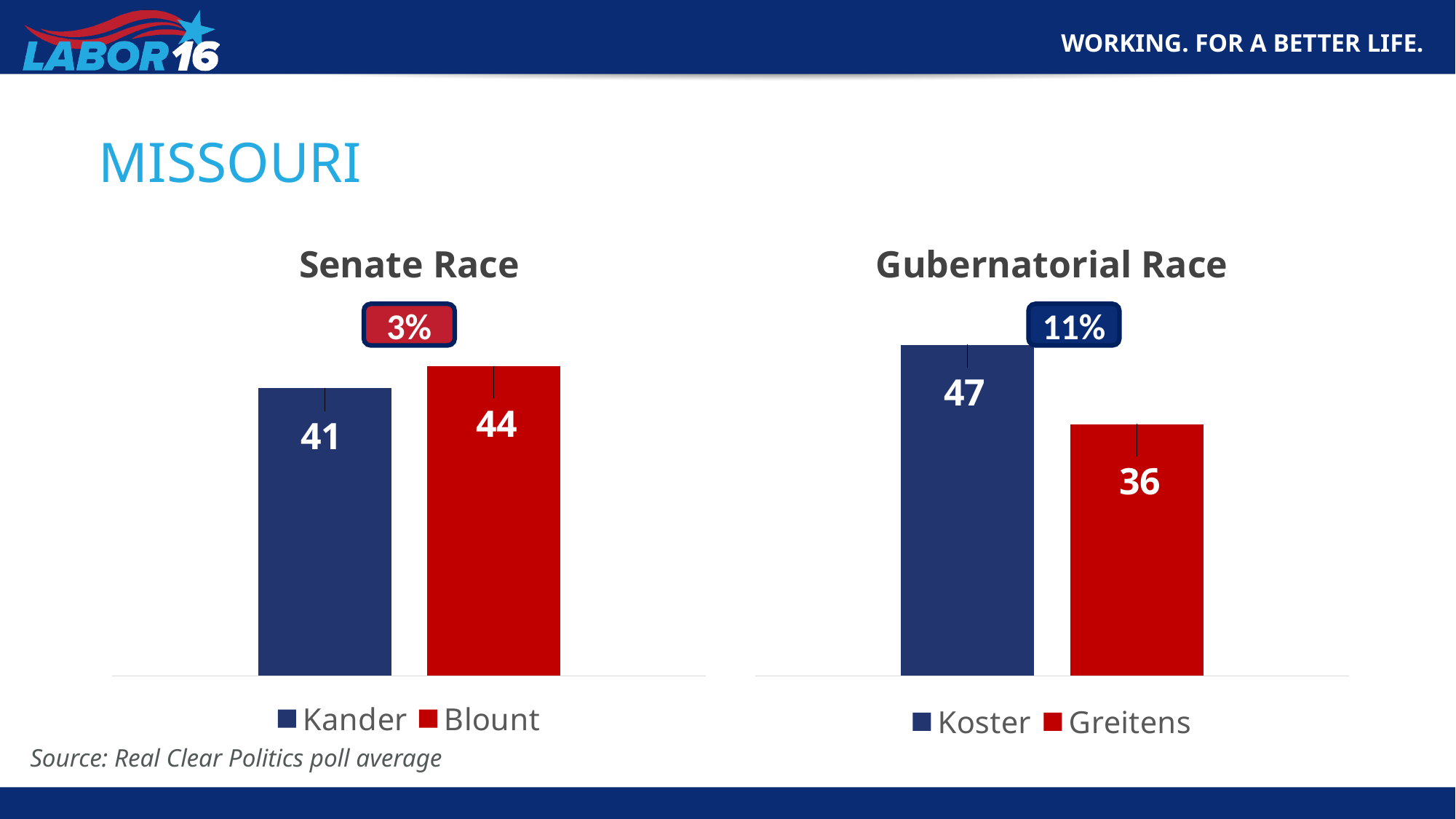
In the Gubernatorial Race chart, what is the difference between Koster's and Greitens's values? 11 In the Gubernatorial Race chart, what is the value for Greitens? 36 In the Senate Race chart, which candidate has the higher value? Blount In the Senate Race chart, what is the value for Kander? 41 What margin is shown in the callout above the Gubernatorial Race chart? 11% In the Senate Race chart, what is the difference between Blount's and Kander's values? 3 In the Gubernatorial Race chart, is Koster's value larger or smaller than Greitens's? larger In the Senate Race chart, what is the value for Blount? 44 In the Gubernatorial Race chart, which candidate has the lower value? Greitens How many series does the legend of the Senate Race chart list? 2 In the Gubernatorial Race chart, what is the value for Koster? 47 What kind of chart is the Gubernatorial Race chart? bar chart